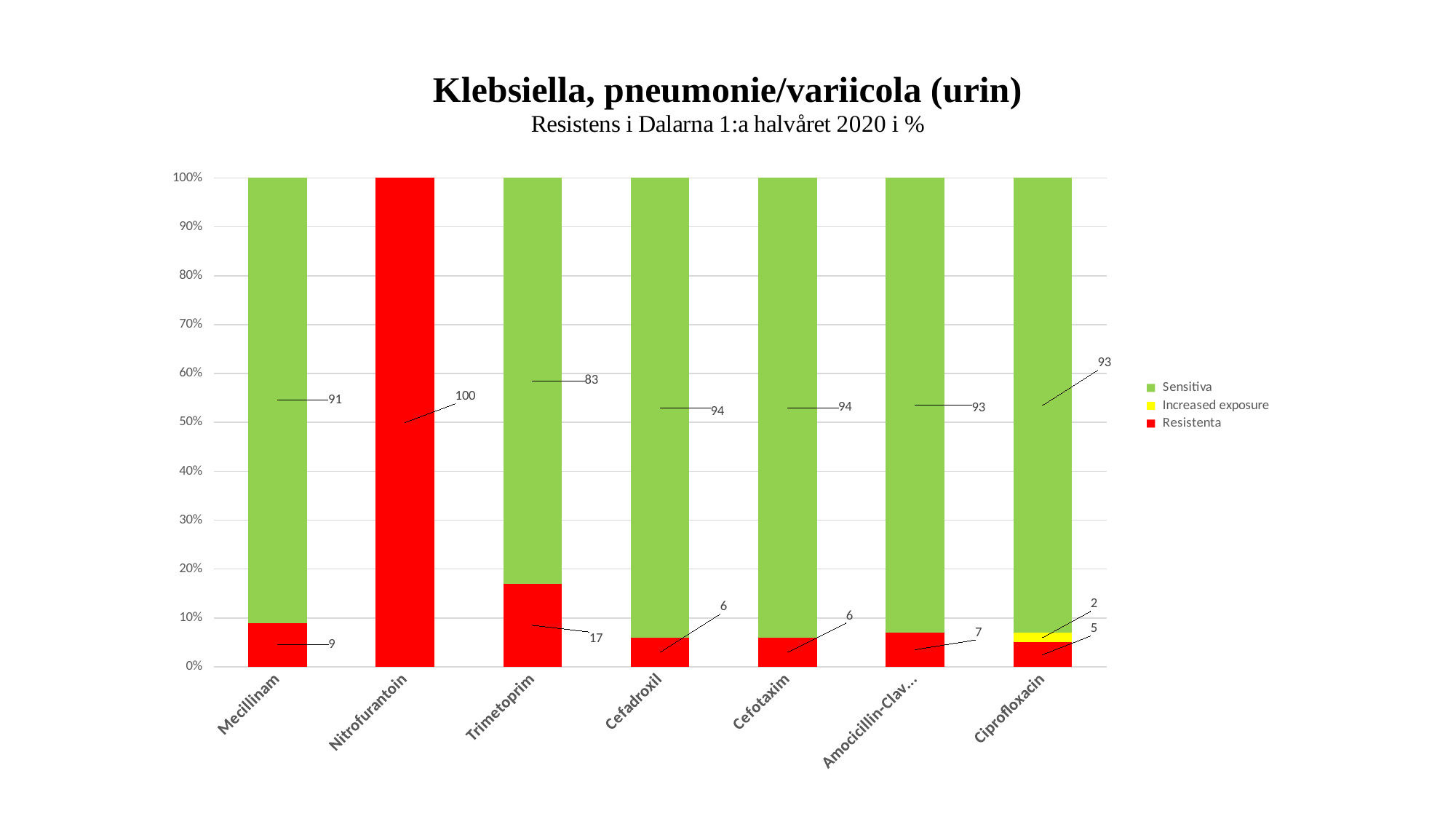
Which antibiotic has the highest Resistenta value? Nitrofurantoin What is the Resistenta value for Nitrofurantoin? 100 What is the difference between the Sensitiva values for Cefadroxil and Trimetoprim? 11 What type of chart is shown on the slide? Stacked bar chart Which is larger, the Resistenta value for Mecillinam or for Ciprofloxacin? Mecillinam What is the Sensitiva value for Mecillinam? 91 How many antibiotic categories are shown on the x axis? 7 What is the Increased exposure value for Ciprofloxacin? 2 How many series does the legend list? 3 Which antibiotic has the highest Sensitiva value? Cefadroxil and Cefotaxim (94) What is the Resistenta value for Trimetoprim? 17 Which series is shown in yellow in the legend? Increased exposure